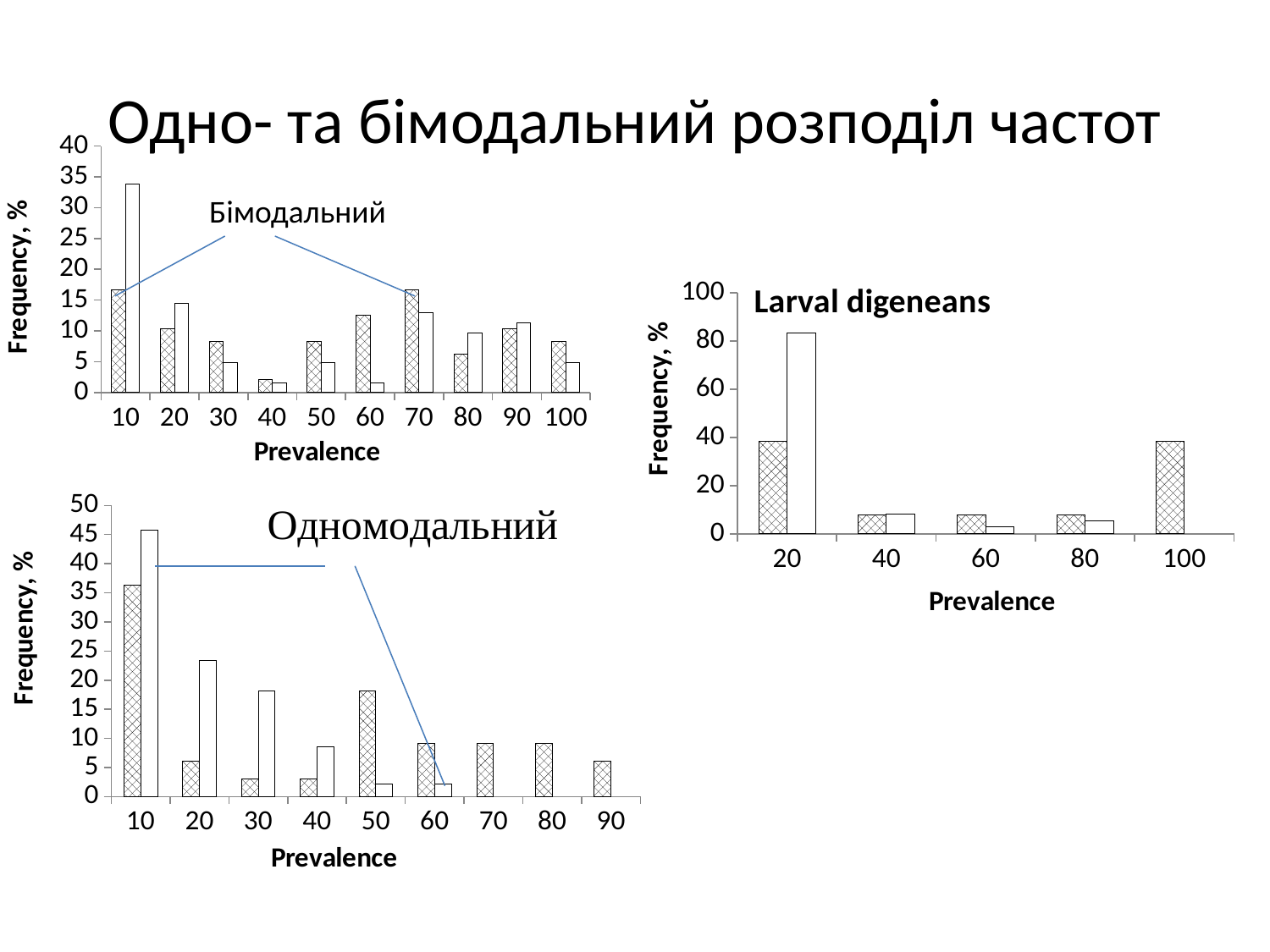
In the 'Larval digeneans' chart, how many prevalence categories are shown on the x axis? 5 In the top-left chart (Бімодальний), how many prevalence categories are shown on the x axis? 10 In the bottom-left chart (Одномодальний), how many prevalence categories are shown on the x axis? 9 In the top-left chart (Бімодальний), is the value of the white bar at prevalence 10 greater or less than 30? greater In the bottom-left chart (Одномодальний), is the value of the white bar at prevalence 10 greater or less than 40? greater In the 'Larval digeneans' chart, at prevalence 20, which bar is taller, the hatched bar or the white bar? the white bar In the 'Larval digeneans' chart, at which prevalence category is the white bar tallest? 20 In the 'Larval digeneans' chart, is the value of the white bar at prevalence 20 greater or less than 80? greater What kind of chart is the 'Larval digeneans' chart? bar chart What is the x-axis title of the 'Larval digeneans' chart? Prevalence